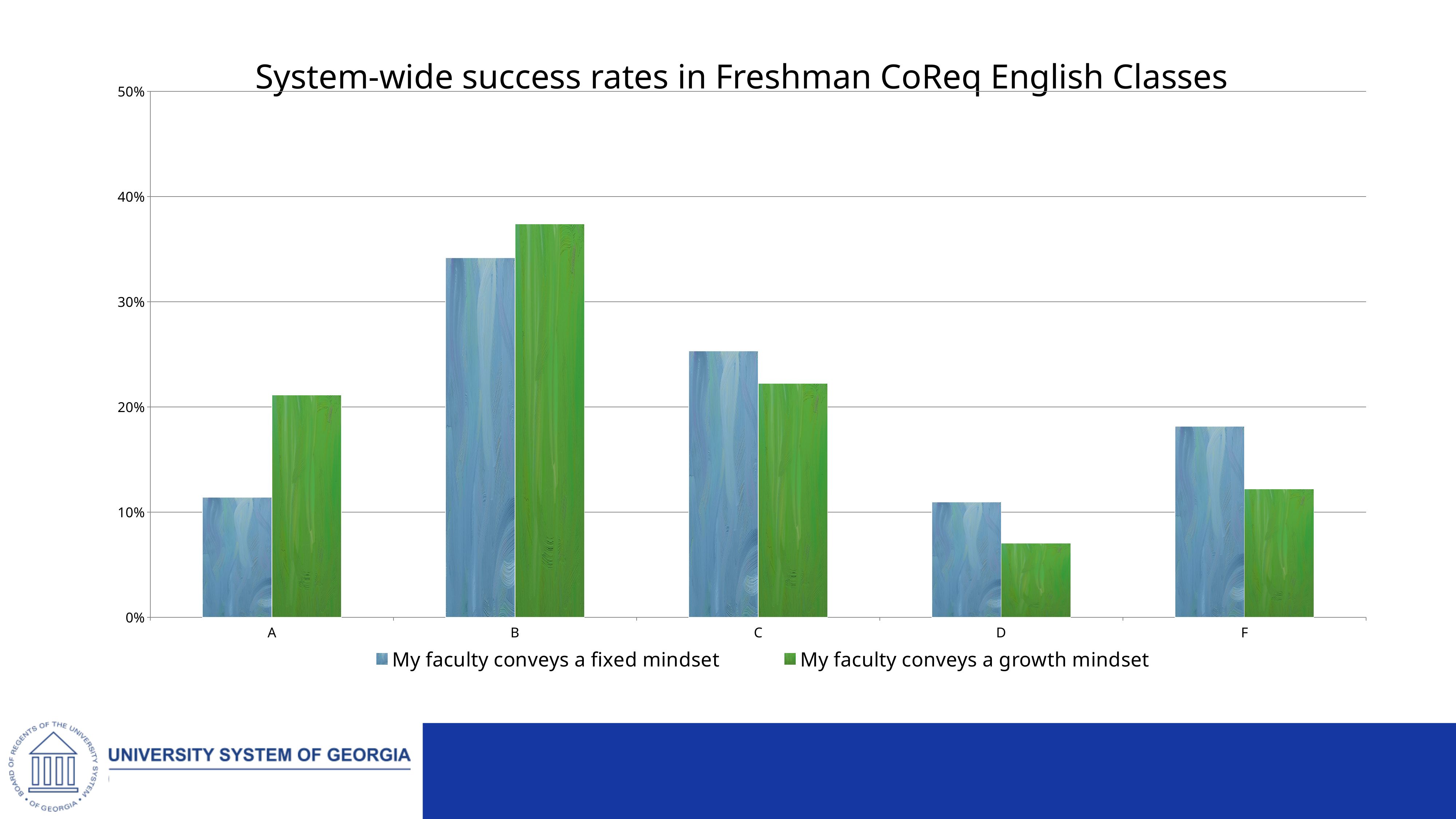
Which grade category has the highest value for the 'My faculty conveys a fixed mindset' series? B Is the value for grade F in the 'My faculty conveys a fixed mindset' series greater or less than 20%? less Is the value for grade B in the 'My faculty conveys a growth mindset' series greater or less than 30%? greater How many grade categories are shown on the x axis? 5 Which grade category has the highest value for the 'My faculty conveys a growth mindset' series? B For grade A, which series has the larger value: fixed mindset or growth mindset? growth mindset How many series does the legend list? 2 Which grade category has the lowest value for the 'My faculty conveys a growth mindset' series? D What is the title of the chart? System-wide success rates in Freshman CoReq English Classes What kind of chart is shown on the slide? bar chart Is the value for grade D in the 'My faculty conveys a growth mindset' series greater or less than 10%? less For grade F, which series has the larger value: fixed mindset or growth mindset? fixed mindset